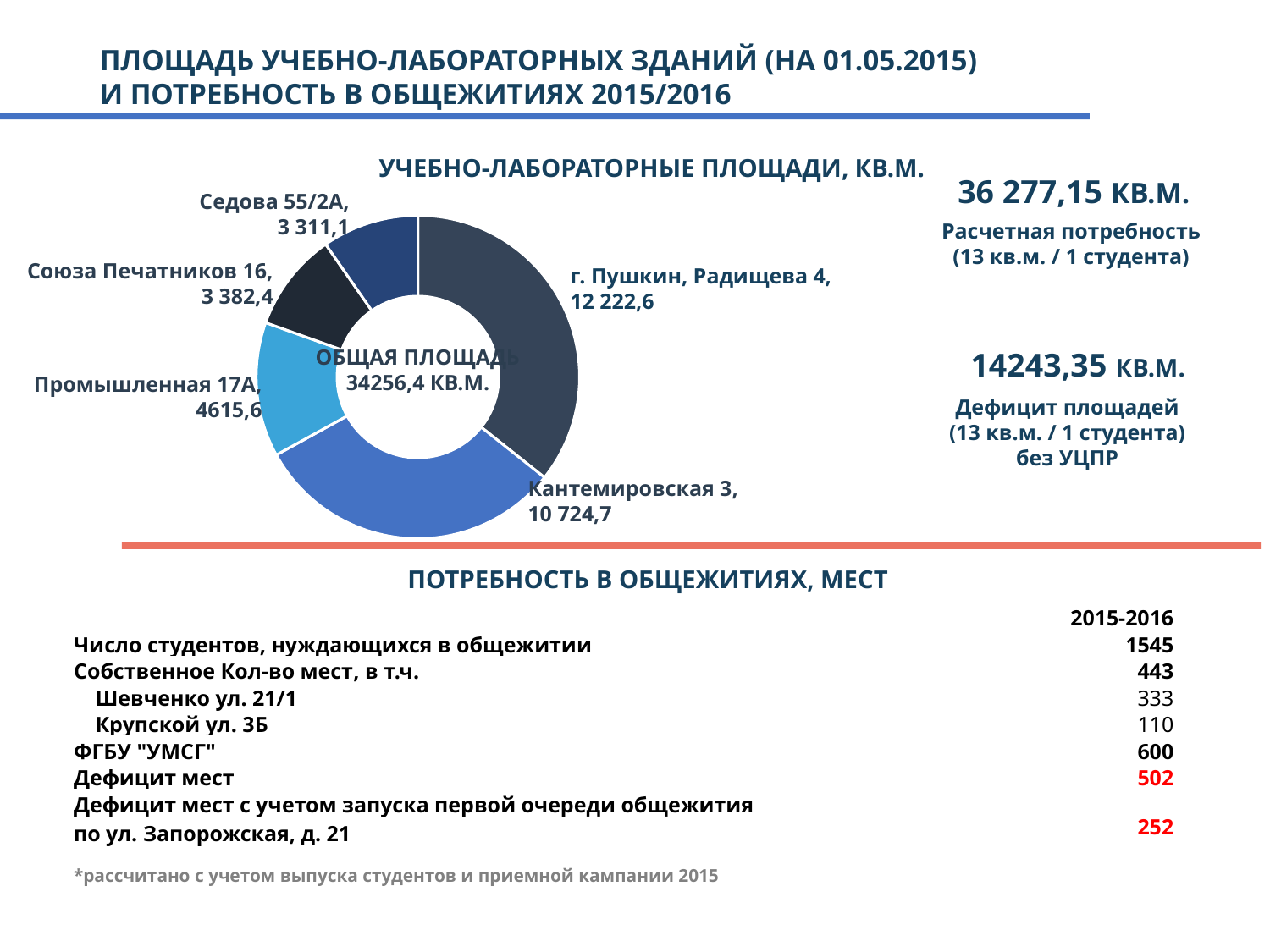
What is the difference in area between г. Пушкин, Радищева 4 and Кантемировская 3? 1 497,9 What is the area for Кантемировская 3? 10 724,7 What is the area for Промышленная 17А? 4615,6 Which has a larger area: Промышленная 17А or Союза Печатников 16? Промышленная 17А What is the area for г. Пушкин, Радищева 4? 12 222,6 How many slices (buildings) does the chart show? 5 What is the area for Седова 55/2А? 3 311,1 Which building has the smallest area? Седова 55/2А What total area is shown in the centre of the chart? 34256,4 КВ.М. What is the title of the chart? УЧЕБНО-ЛАБОРАТОРНЫЕ ПЛОЩАДИ, КВ.М. Which building has the largest area? г. Пушкин, Радищева 4 What kind of chart is shown on the slide? Doughnut (pie) chart